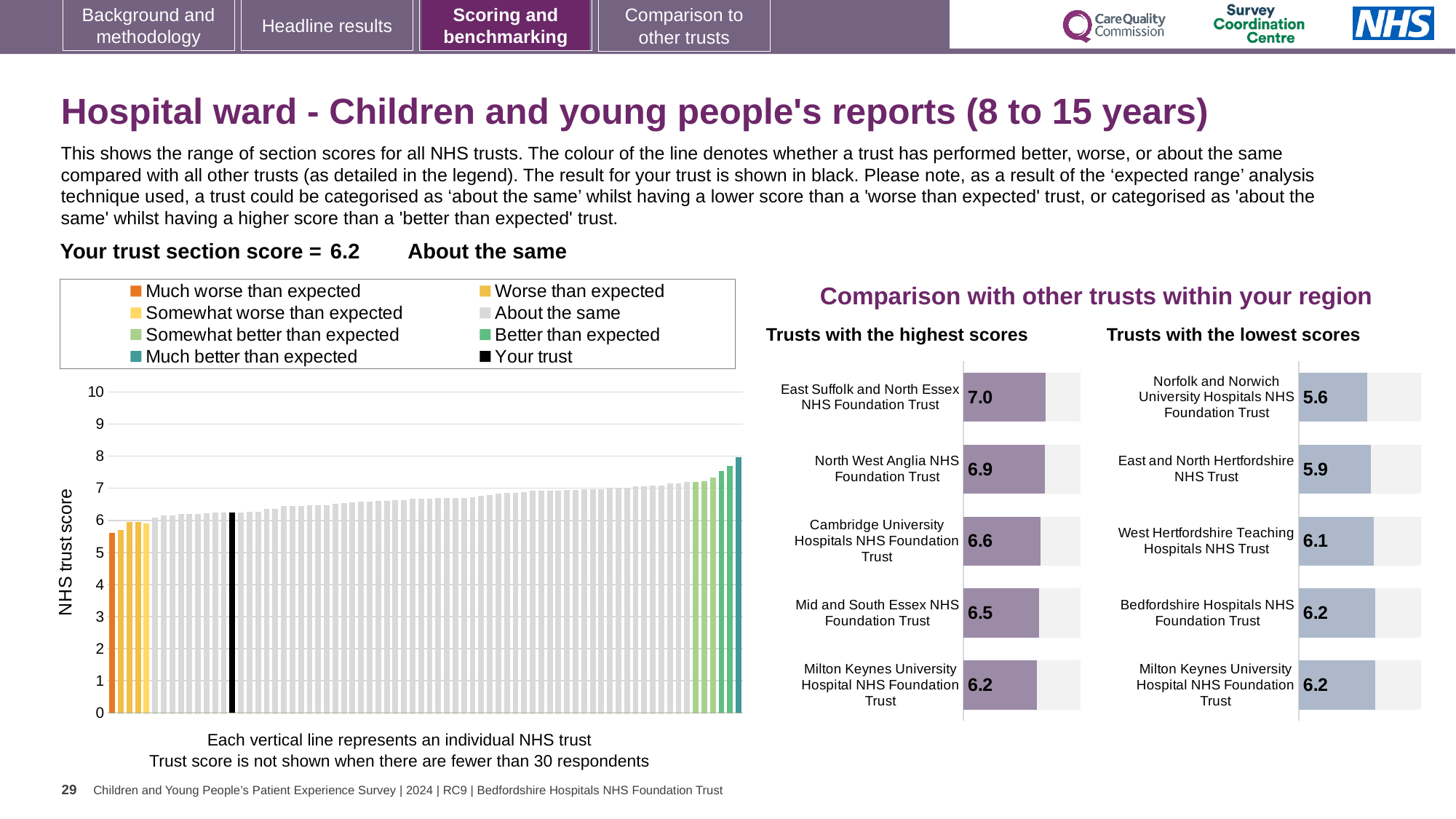
In the 'Trusts with the highest scores' chart, which has the higher score: North West Anglia NHS Foundation Trust or Mid and South Essex NHS Foundation Trust? North West Anglia NHS Foundation Trust In the main NHS trust score chart on the left, do the values rise or fall from left to right? Rise In the 'Trusts with the lowest scores' chart, which trust has the lowest score? Norfolk and Norwich University Hospitals NHS Foundation Trust In the 'Trusts with the highest scores' chart, what is the difference between the scores of East Suffolk and North Essex NHS Foundation Trust and Milton Keynes University Hospital NHS Foundation Trust? 0.8 In the main NHS trust score chart on the left, is the value of the black 'Your trust' bar greater or less than 6? greater How many entries does the legend of the main NHS trust score chart list? 8 How many trusts are shown in the 'Trusts with the lowest scores' chart? 5 What kind of chart is the main chart showing NHS trust scores on the left of the slide? Bar chart In the 'Trusts with the highest scores' chart, what is the score for East Suffolk and North Essex NHS Foundation Trust? 7.0 In the 'Trusts with the lowest scores' chart, what is the difference between the scores of Bedfordshire Hospitals NHS Foundation Trust and Norfolk and Norwich University Hospitals NHS Foundation Trust? 0.6 In the 'Trusts with the lowest scores' chart, what is the score for West Hertfordshire Teaching Hospitals NHS Trust? 6.1 In the 'Trusts with the highest scores' chart, what is the score for Cambridge University Hospitals NHS Foundation Trust? 6.6